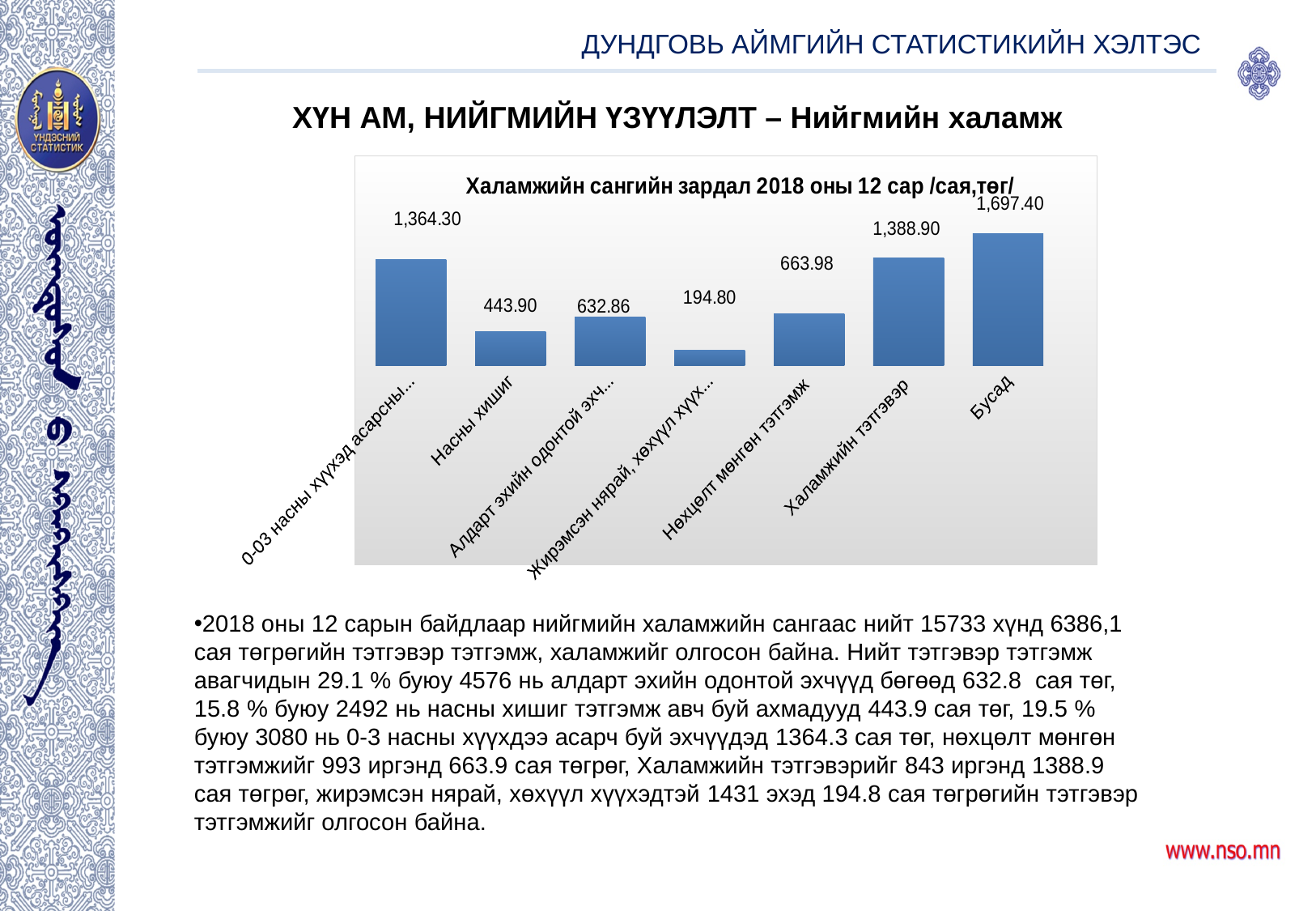
What is the lowest value shown in the chart? 194.80 What is the difference between the values for Нөхцөлт мөнгөн тэтгэмж and Насны хишиг? 220.08 How many categories (bars) are shown in the chart? 7 What kind of chart is shown on the slide? Bar chart What is the difference between the values for Бусад and Халамжийн тэтгэвэр? 308.50 What is the value for Нөхцөлт мөнгөн тэтгэмж? 663.98 What is the value for Бусад? 1,697.40 Which category has the highest value in the chart? Бусад What is the value for Халамжийн тэтгэвэр? 1,388.90 What is the value for Насны хишиг in the chart? 443.90 Which is larger, the value for Насны хишиг or the value for Нөхцөлт мөнгөн тэтгэмж? Нөхцөлт мөнгөн тэтгэмж What is the title of the chart? Халамжийн сангийн зардал 2018 оны 12 сар /сая,төг/